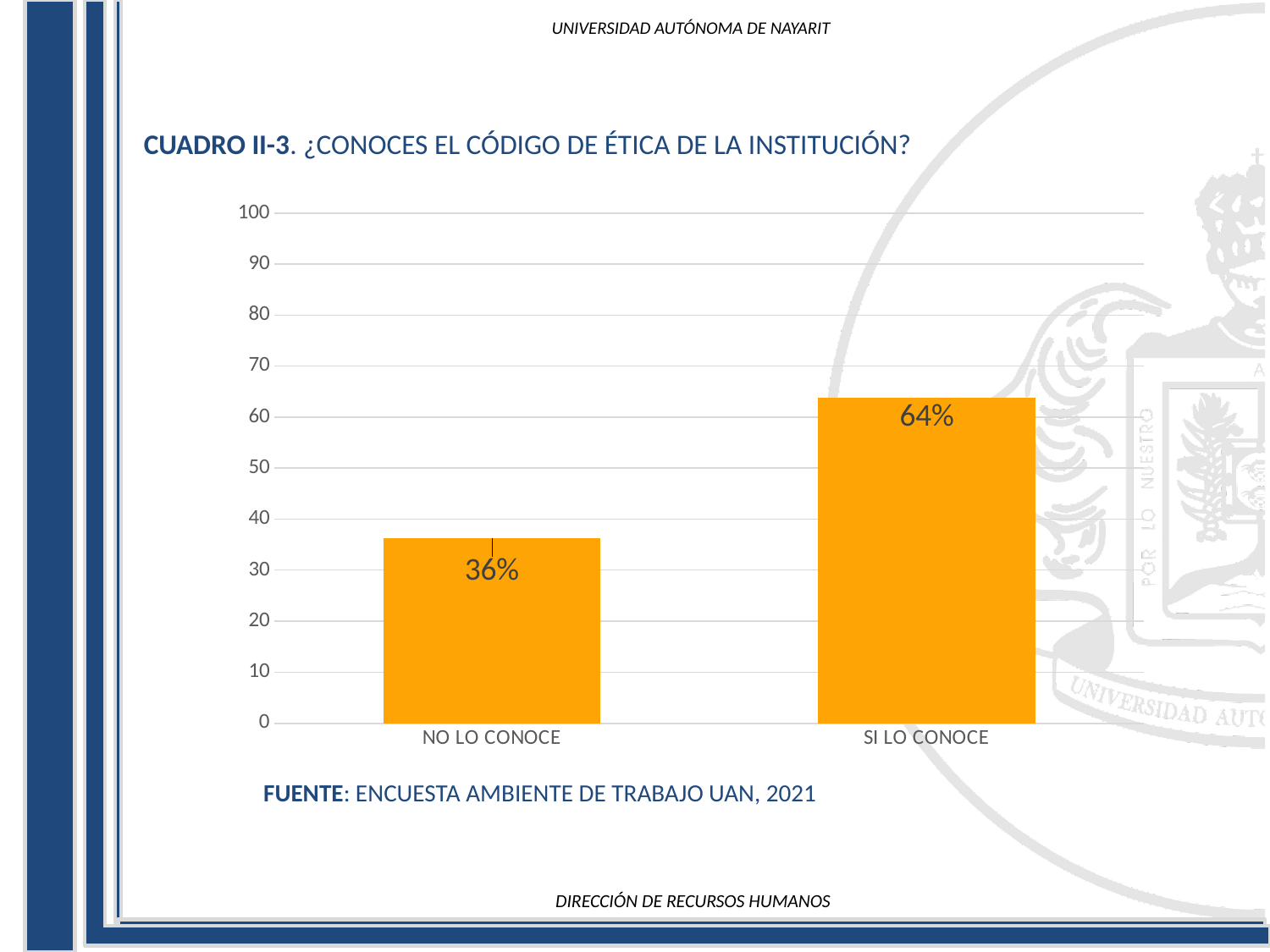
What is the difference between the values for SI LO CONOCE and NO LO CONOCE? 28% How many categories are shown on the x axis? 2 Which category has the highest value? SI LO CONOCE What kind of chart is shown on the slide? bar chart What is the title of the chart (CUADRO II-3)? ¿CONOCES EL CÓDIGO DE ÉTICA DE LA INSTITUCIÓN? Which is larger, the value for NO LO CONOCE or the value for SI LO CONOCE? SI LO CONOCE What is the value for SI LO CONOCE? 64% Is the value for NO LO CONOCE greater or less than 40? less Is the value for SI LO CONOCE greater or less than 50? greater What is the source cited below the chart? ENCUESTA AMBIENTE DE TRABAJO UAN, 2021 What is the value for NO LO CONOCE? 36% Which category has the lowest value? NO LO CONOCE